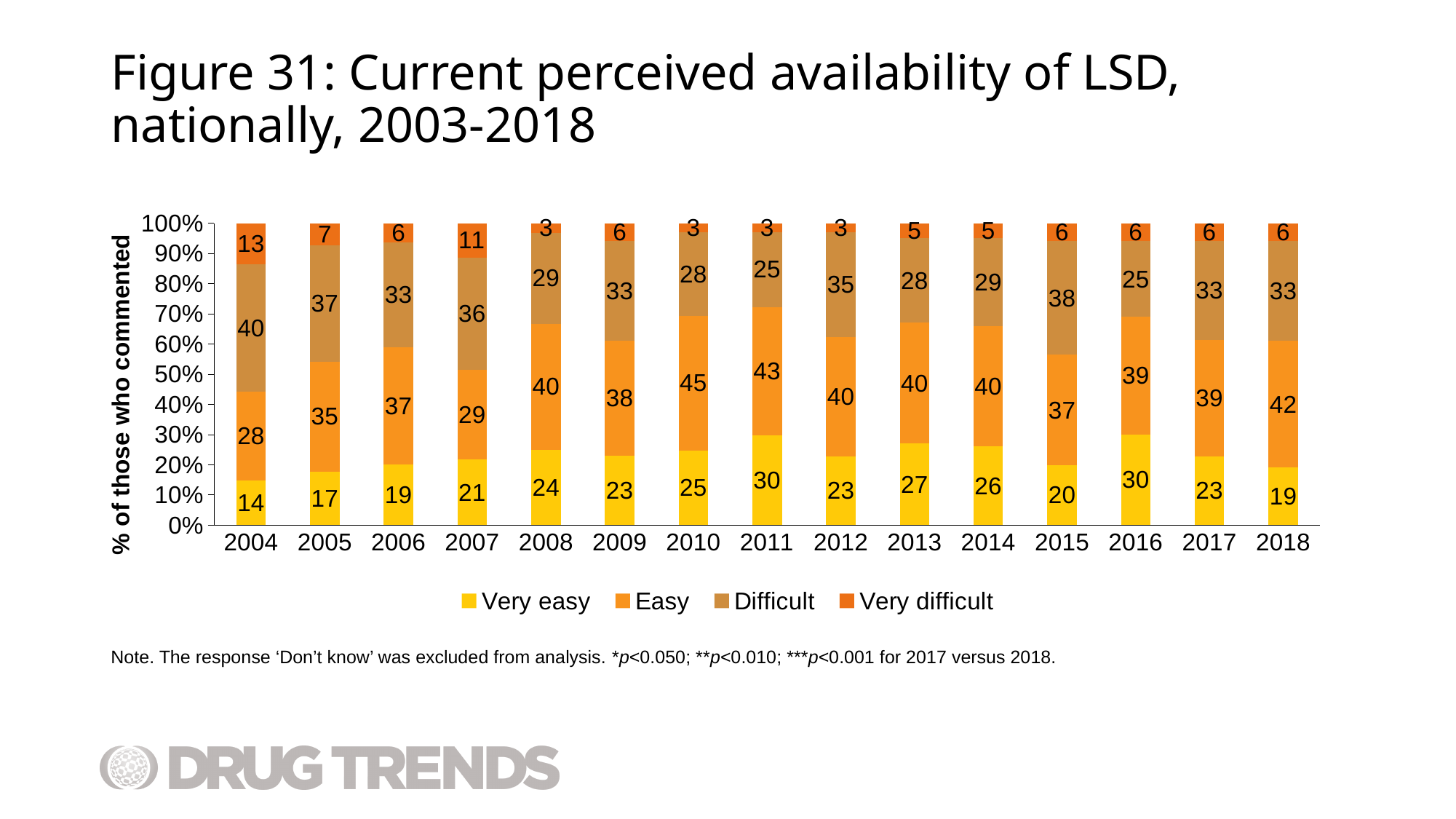
How many years are shown on the x axis? 15 In which year is the 'Easy' value highest? 2010 What is the y-axis label of the chart? % of those who commented Which is larger, the 'Very easy' value for 2013 or for 2015? 2013 What is the difference between the 'Difficult' values for 2015 and 2016? 13 What is the 'Very difficult' value for 2004? 13 What is the 'Easy' value for 2018? 42 How many series does the legend list? 4 What percentage of respondents rated LSD as 'Very easy' to obtain in 2011? 30 In which year is the 'Difficult' value highest? 2004 What type of chart is shown on the slide? Stacked bar chart In which year is the 'Very easy' value lowest? 2004